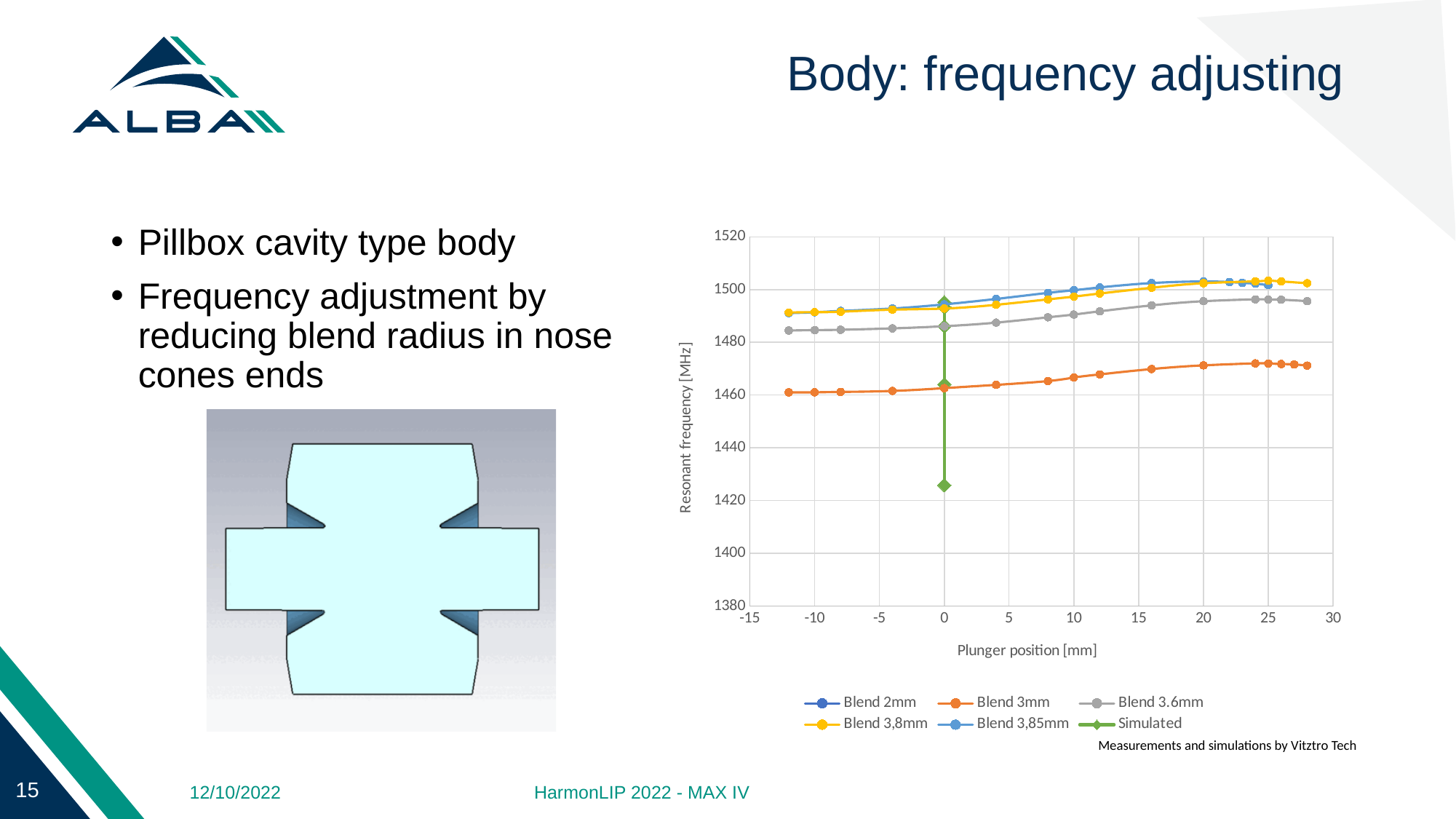
Is the lowest Simulated point on the chart greater or less than 1440? less How many series does the chart legend list? 6 Is the resonant frequency for Blend 3mm at plunger position -10 greater or less than 1440? greater Among the Blend series, which one has the lowest resonant frequency at plunger position 0? Blend 3mm What kind of chart is shown on the slide? line chart What is the label of the x axis of the chart? Plunger position [mm] Is the resonant frequency for Blend 3.6mm at plunger position 0 greater or less than 1500? less What is the label of the y axis of the chart? Resonant frequency [MHz] Does the resonant frequency for Blend 3mm rise or fall as the plunger position increases? rises At plunger position 10, which series has the higher resonant frequency, Blend 3mm or Blend 3.6mm? Blend 3.6mm